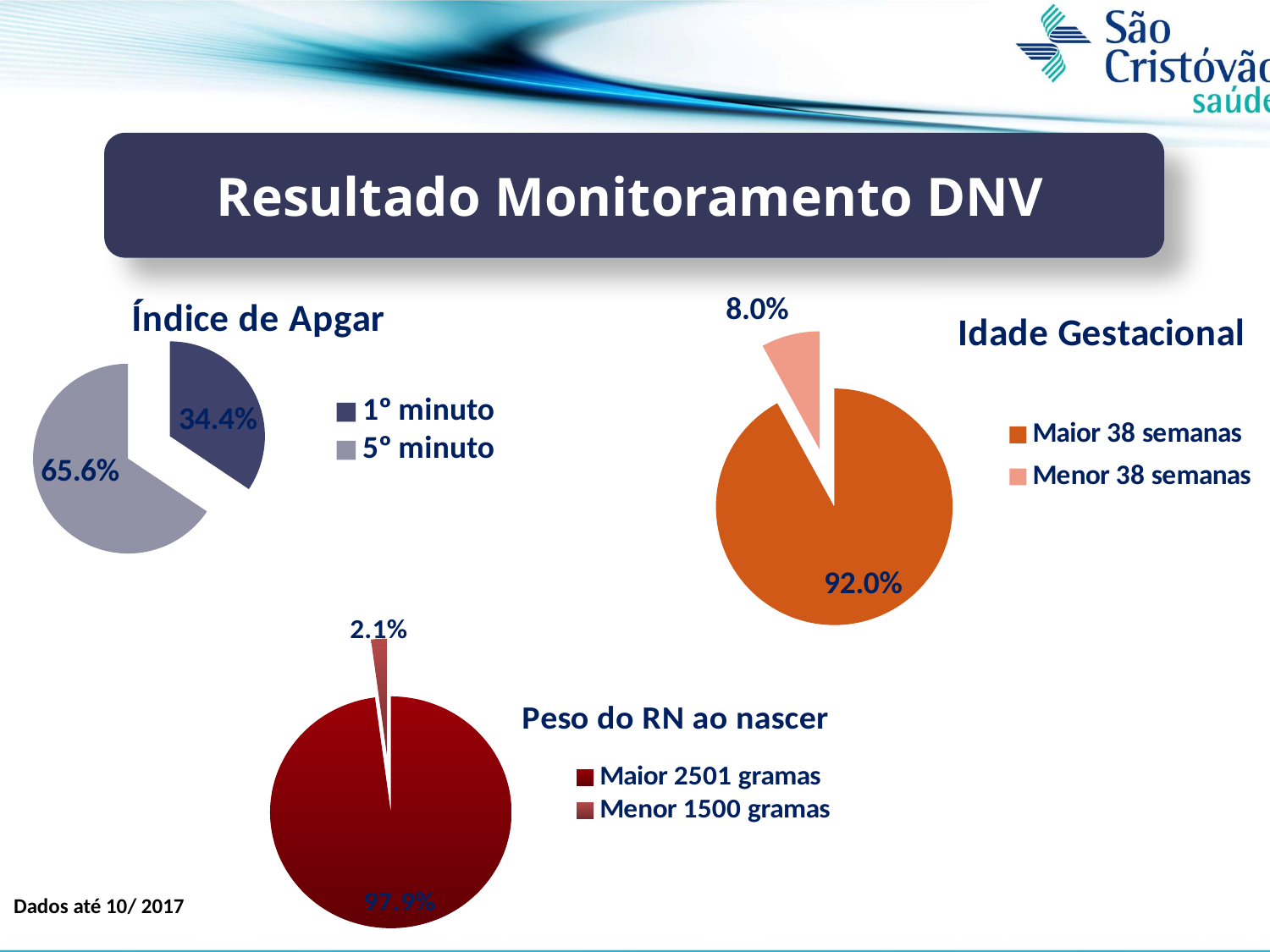
In the 'Peso do RN ao nascer' chart, what is the value for 'Menor 1500 gramas'? 2.1% In the 'Peso do RN ao nascer' chart, which category has the largest slice? Maior 2501 gramas In the 'Índice de Apgar' chart, what is the difference between the '5º minuto' and '1º minuto' values? 31.2% In the 'Peso do RN ao nascer' chart, what is the value for 'Maior 2501 gramas'? 97.9% In the 'Idade Gestacional' chart, what is the value for 'Menor 38 semanas'? 8.0% What kind of chart is the 'Idade Gestacional' chart? Pie chart In the 'Índice de Apgar' chart, which slice is larger, '1º minuto' or '5º minuto'? 5º minuto In the 'Idade Gestacional' chart, which category has the smallest slice? Menor 38 semanas In the 'Índice de Apgar' chart, what is the value for '1º minuto'? 34.4% In the 'Índice de Apgar' chart, what is the value for '5º minuto'? 65.6% In the 'Idade Gestacional' chart, what is the value for 'Maior 38 semanas'? 92.0% How many categories does the legend of the 'Peso do RN ao nascer' chart list? 2